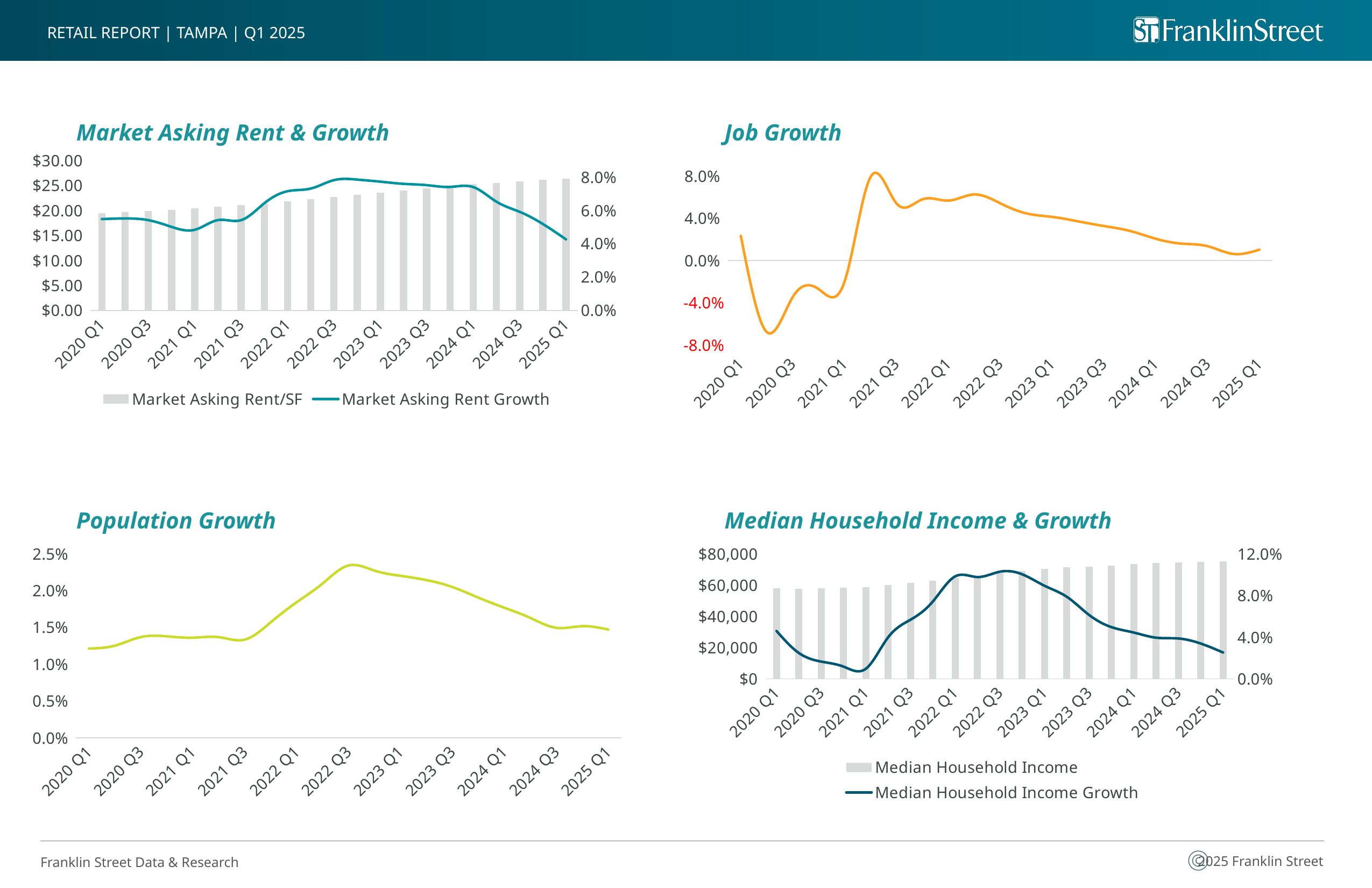
In the Median Household Income & Growth chart, is the Median Household Income Growth value for 2021 Q1 greater or less than 4.0%? less In the Job Growth chart, what kind of chart is used? line chart In the Median Household Income & Growth chart, is the Median Household Income bar for 2025 Q1 greater or less than $60,000? greater In the Job Growth chart, is the value for 2025 Q1 greater or less than 0.0%? greater In the Market Asking Rent & Growth chart, how many series does the legend list? 2 In the Market Asking Rent & Growth chart, do the Market Asking Rent/SF bars rise or fall from 2020 Q1 to 2025 Q1? rise In the Population Growth chart, does the line rise or fall from 2022 Q3 to 2025 Q1? fall In the Median Household Income & Growth chart, how many series does the legend list? 2